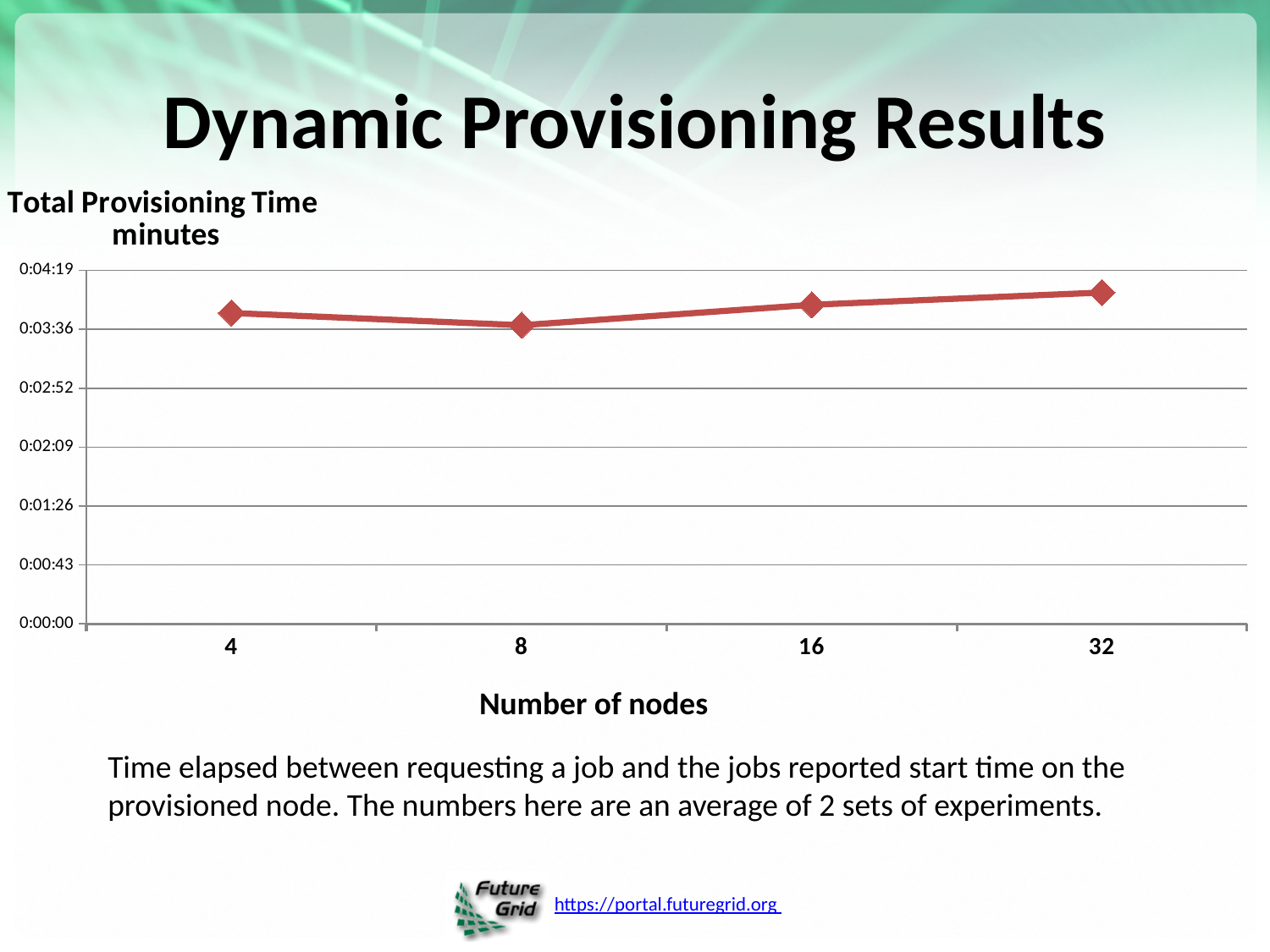
Is the total provisioning time for 4 nodes greater or less than 0:03:36? greater From 8 nodes to 32 nodes, does the total provisioning time rise or fall? rise Which number of nodes has the highest total provisioning time? 32 Is the total provisioning time for 32 nodes greater or less than 0:04:19? less What kind of chart is shown on the slide? line chart What is the label of the x axis? Number of nodes Is the total provisioning time for 16 nodes greater or less than 0:02:52? greater Which has a larger total provisioning time, 4 nodes or 8 nodes? 4 nodes How many data points are plotted on the line? 4 Which has a larger total provisioning time, 8 nodes or 32 nodes? 32 nodes Which number of nodes has the lowest total provisioning time? 8 What is the title of the chart? Total Provisioning Time minutes